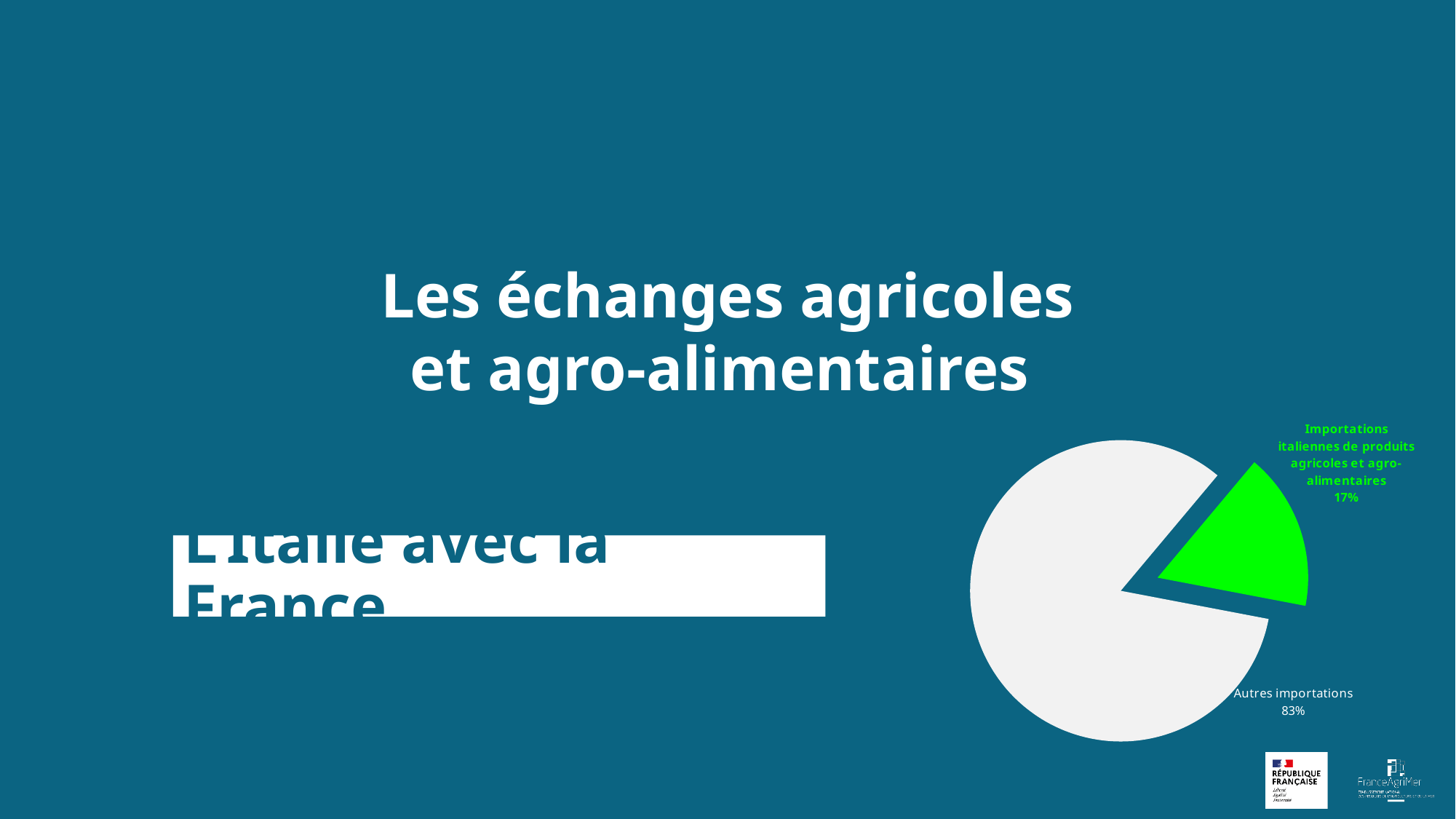
How many slices does the pie chart have? 2 What colour is the "Importations italiennes de produits agricoles et agro-alimentaires" slice? green What share of the pie is labelled "Autres importations"? 83% What kind of chart is shown on the slide? pie chart Which is larger: the "Autres importations" slice or the "Importations italiennes de produits agricoles et agro-alimentaires" slice? Autres importations Which slice of the pie chart is the smallest? Importations italiennes de produits agricoles et agro-alimentaires What colour is the "Autres importations" slice? light grey Which slice of the pie chart is the largest? Autres importations What is the difference in percentage points between the "Autres importations" slice and the "Importations italiennes de produits agricoles et agro-alimentaires" slice? 66 What share of the pie is labelled "Importations italiennes de produits agricoles et agro-alimentaires"? 17%